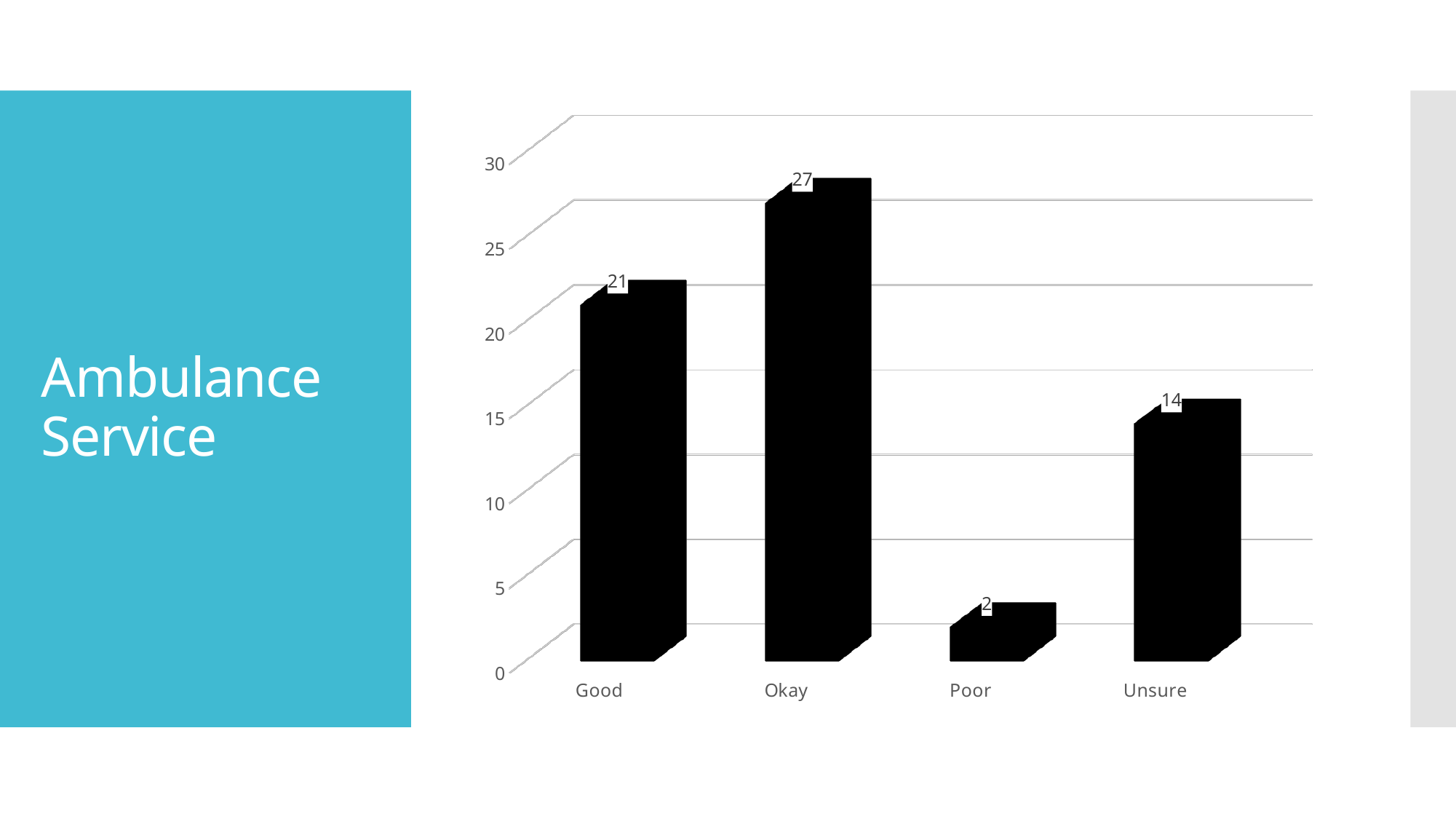
Which is larger, the value for Good or the value for Unsure? Good What is the value for Unsure? 14 What is the value for Okay? 27 What is the difference between the values for Unsure and Poor? 12 Which category has the highest value? Okay What kind of chart is shown on the slide? Bar chart Which category has the lowest value? Poor What is the value for Good? 21 What is the value for Poor? 2 What is the difference between the values for Okay and Good? 6 What is the title text shown on the left of the slide? Ambulance Service How many categories are shown on the x axis? 4